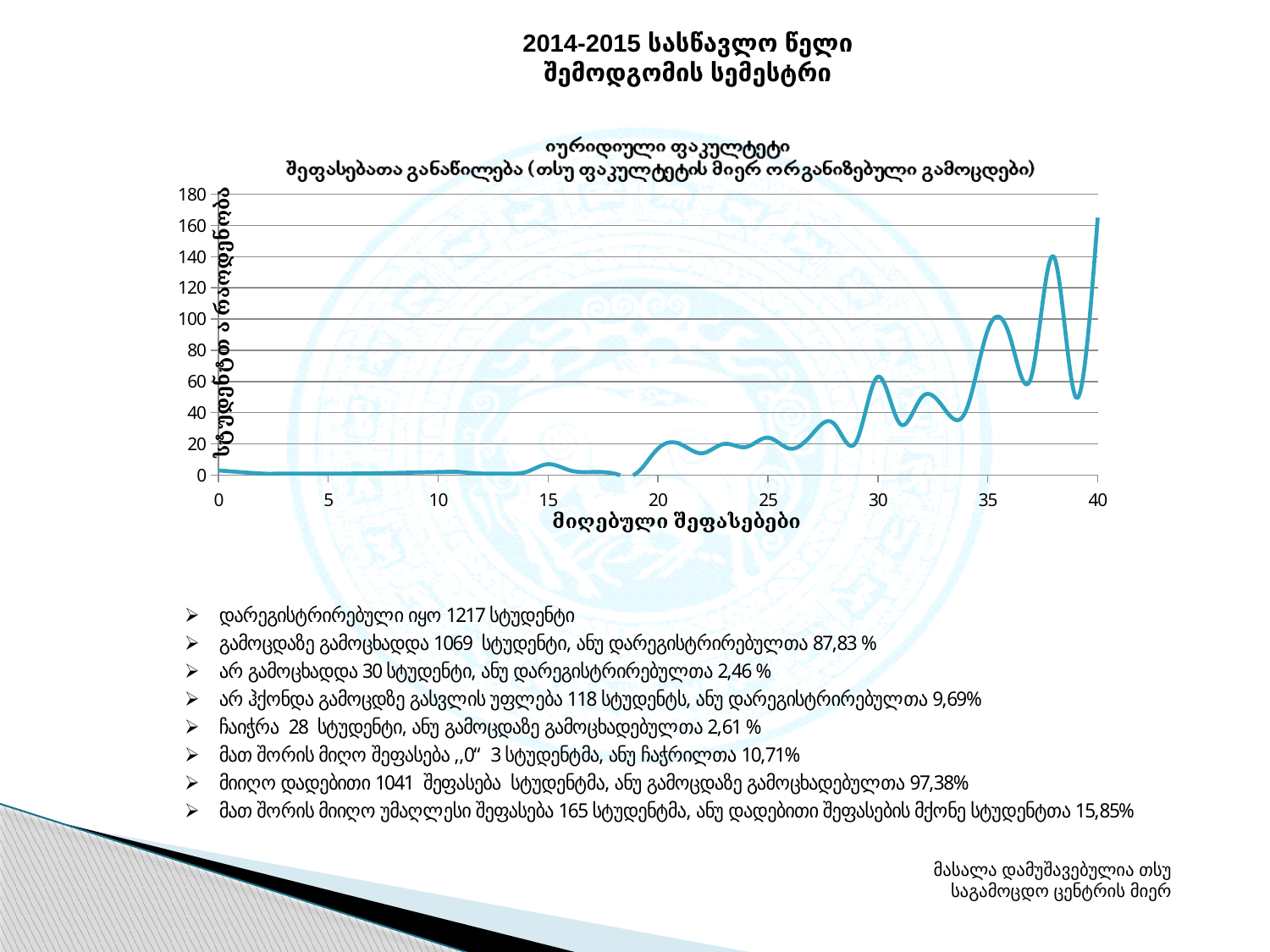
What is the label of the x axis? მიღებული შეფასებები What is the highest tick value shown on the y axis? 180 What kind of chart is shown on the slide? line chart Which score has more students, 30 or 35? 35 Is the number of students at score 35 greater or less than 60? greater Is the number of students at score 25 greater or less than 40? less Is the number of students at score 30 greater or less than 80? less Which score has more students, 20 or 40? 40 Overall, does the number of students rise or fall as the score increases along the x axis? rise At which score on the x axis does the line reach its highest value? 40